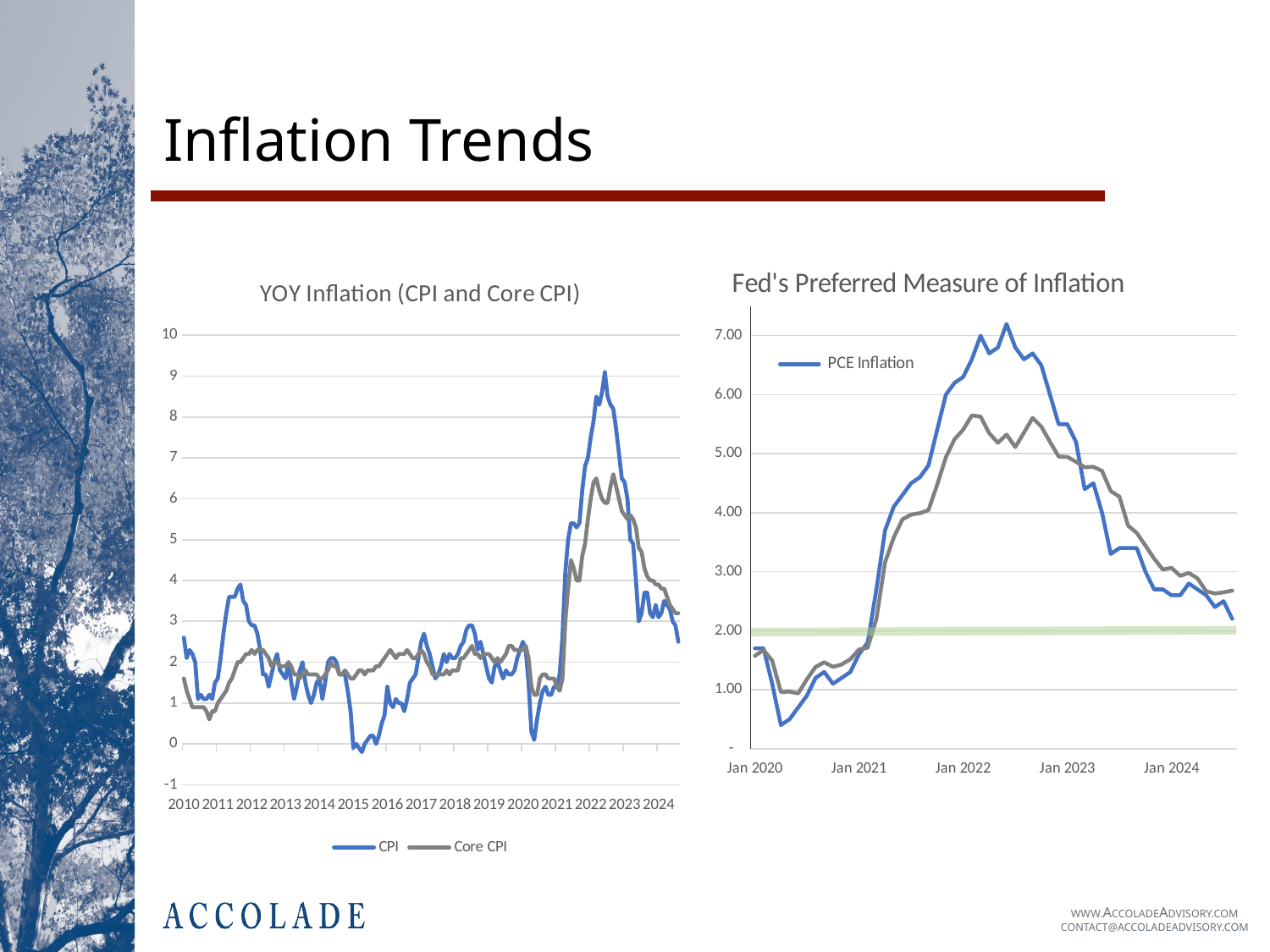
In the 'Fed's Preferred Measure of Inflation' chart, is the value of the PCE Inflation line at Jan 2024 greater or less than 3.00? less In the 'YOY Inflation (CPI and Core CPI)' chart, which series reaches the higher peak, CPI or Core CPI? CPI What are the two series named in the legend of the 'YOY Inflation (CPI and Core CPI)' chart? CPI and Core CPI In the 'Fed's Preferred Measure of Inflation' chart, does the PCE Inflation line rise or fall between Jan 2023 and Jan 2024? fall How many series does the legend of the 'YOY Inflation (CPI and Core CPI)' chart list? 2 In the 'YOY Inflation (CPI and Core CPI)' chart, is the lowest value of the CPI line in 2015 greater or less than 1? less What kind of chart is the 'YOY Inflation (CPI and Core CPI)' chart? line chart In the 'YOY Inflation (CPI and Core CPI)' chart, is the peak value of the Core CPI line in 2022 greater or less than 7? less How many year labels are shown on the x axis of the 'YOY Inflation (CPI and Core CPI)' chart? 15 What is the title of the chart on the right side of the slide? Fed's Preferred Measure of Inflation